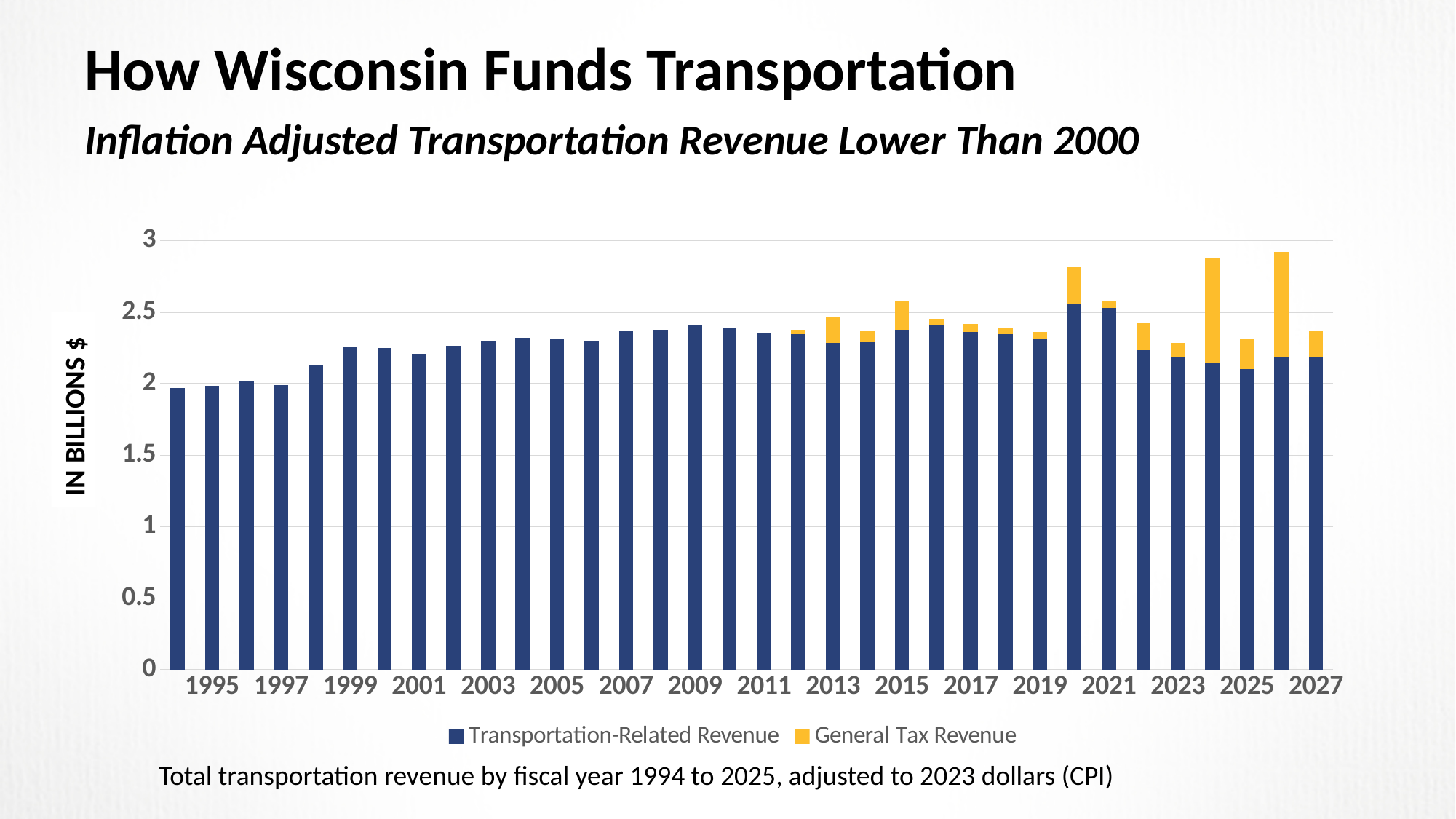
Does Transportation-Related Revenue generally rise or fall from 1994 to 2009? rise What are the two series named in the legend? Transportation-Related Revenue and General Tax Revenue How many series does the legend list? 2 Which year has the larger General Tax Revenue segment, 2024 or 2025? 2024 Which year has the larger total stacked bar, 2020 or 2021? 2020 What kind of chart is shown on the slide? Stacked bar chart Is the total stacked bar for 2026 greater or less than 2.5? greater Is the Transportation-Related Revenue value for 1999 greater or less than 2? greater Is the Transportation-Related Revenue value for 2009 greater or less than 2.5? less What is the label on the vertical axis? IN BILLIONS $